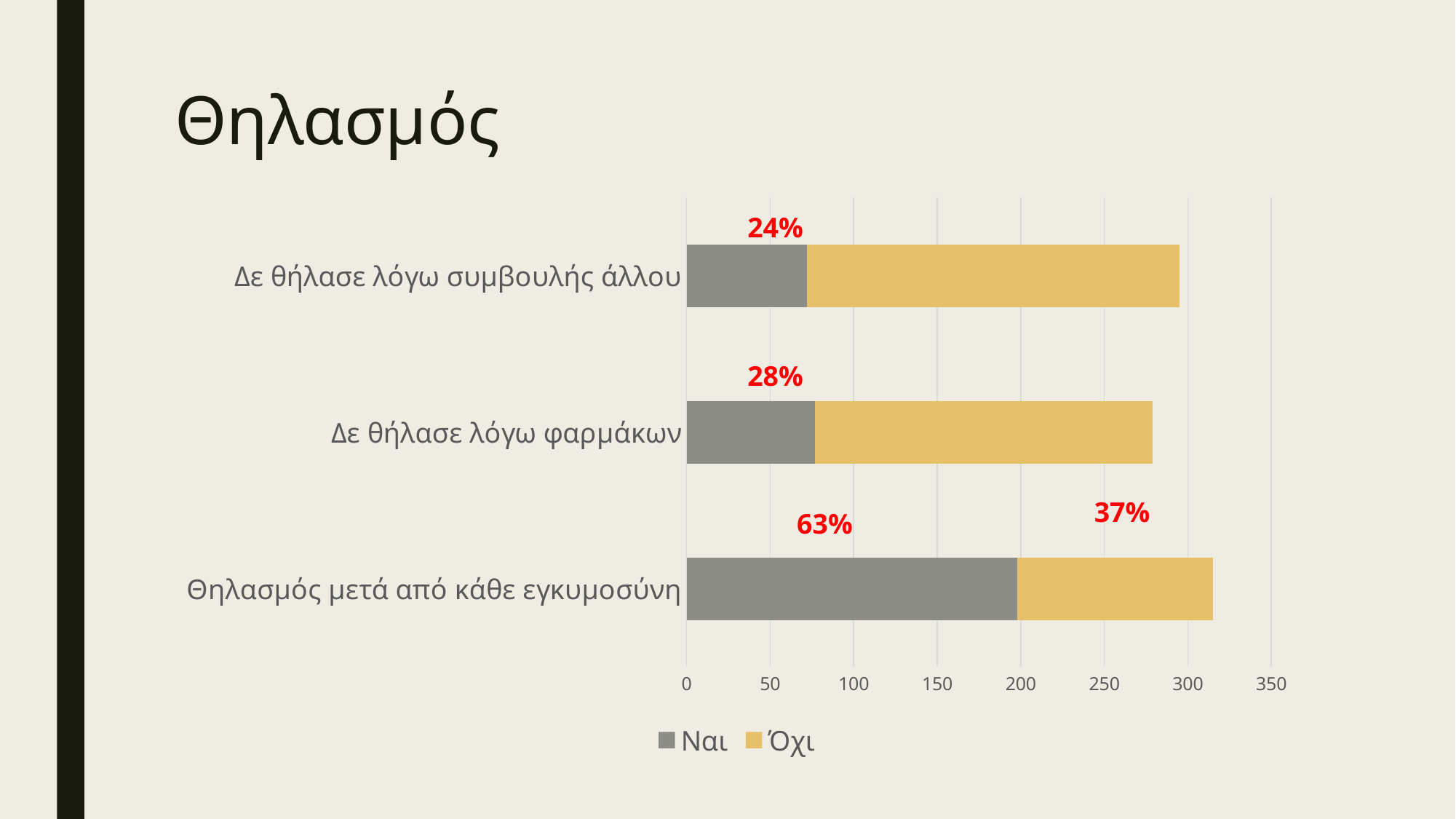
What percentage label is printed above the Ναι segment of the bar for Θηλασμός μετά από κάθε εγκυμοσύνη? 63% What are the two series named in the legend? Ναι and Όχι Is the total length of the stacked bar for Θηλασμός μετά από κάθε εγκυμοσύνη greater or less than 300? greater What is the title of the slide containing the chart? Θηλασμός For Θηλασμός μετά από κάθε εγκυμοσύνη, which is larger, the Ναι segment or the Όχι segment? Ναι What percentage label is printed above the bar for Δε θήλασε λόγω φαρμάκων? 28% How many series does the legend list? 2 Which category has the longest total stacked bar? Θηλασμός μετά από κάθε εγκυμοσύνη What kind of chart is shown on the slide? Stacked bar chart Is the Ναι value for Θηλασμός μετά από κάθε εγκυμοσύνη greater or less than 150? greater How many categories are plotted on the chart? 3 Is the Ναι value for Δε θήλασε λόγω φαρμάκων greater or less than 100? less